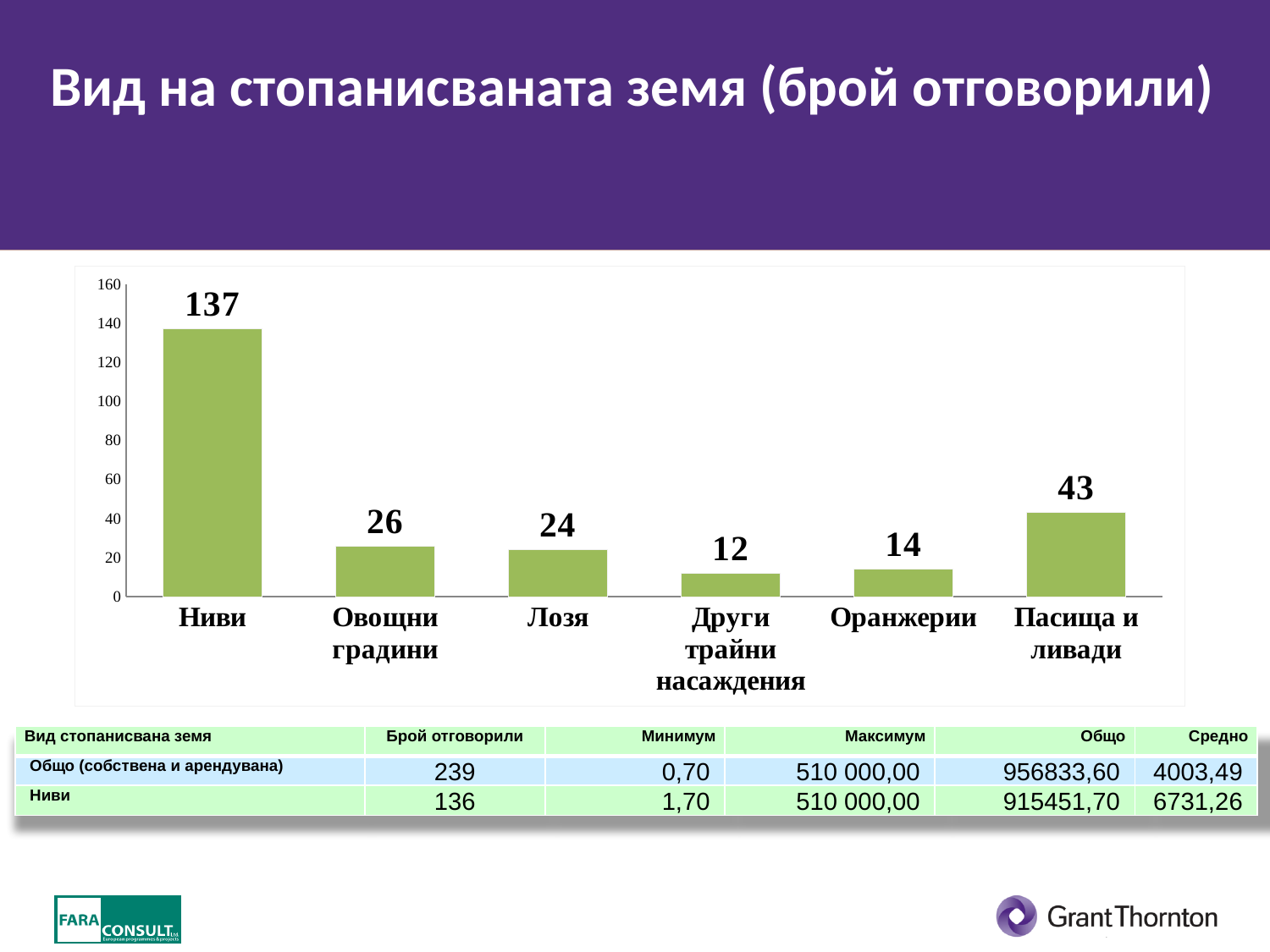
Which is larger, the value for Овощни градини or the value for Оранжерии? Овощни градини Which category has the highest value? Ниви What is the title of the slide containing the chart? Вид на стопанисваната земя (брой отговорили) What is the value for Пасища и ливади? 43 What kind of chart is shown on the slide? bar chart How many categories are shown on the x axis? 6 What is the difference between the values for Ниви and Пасища и ливади? 94 Which category has the lowest value? Други трайни насаждения What is the value for Ниви? 137 What is the difference between the values for Лозя and Оранжерии? 10 What is the value for Други трайни насаждения? 12 Is the value for Ниви greater or less than 120? greater